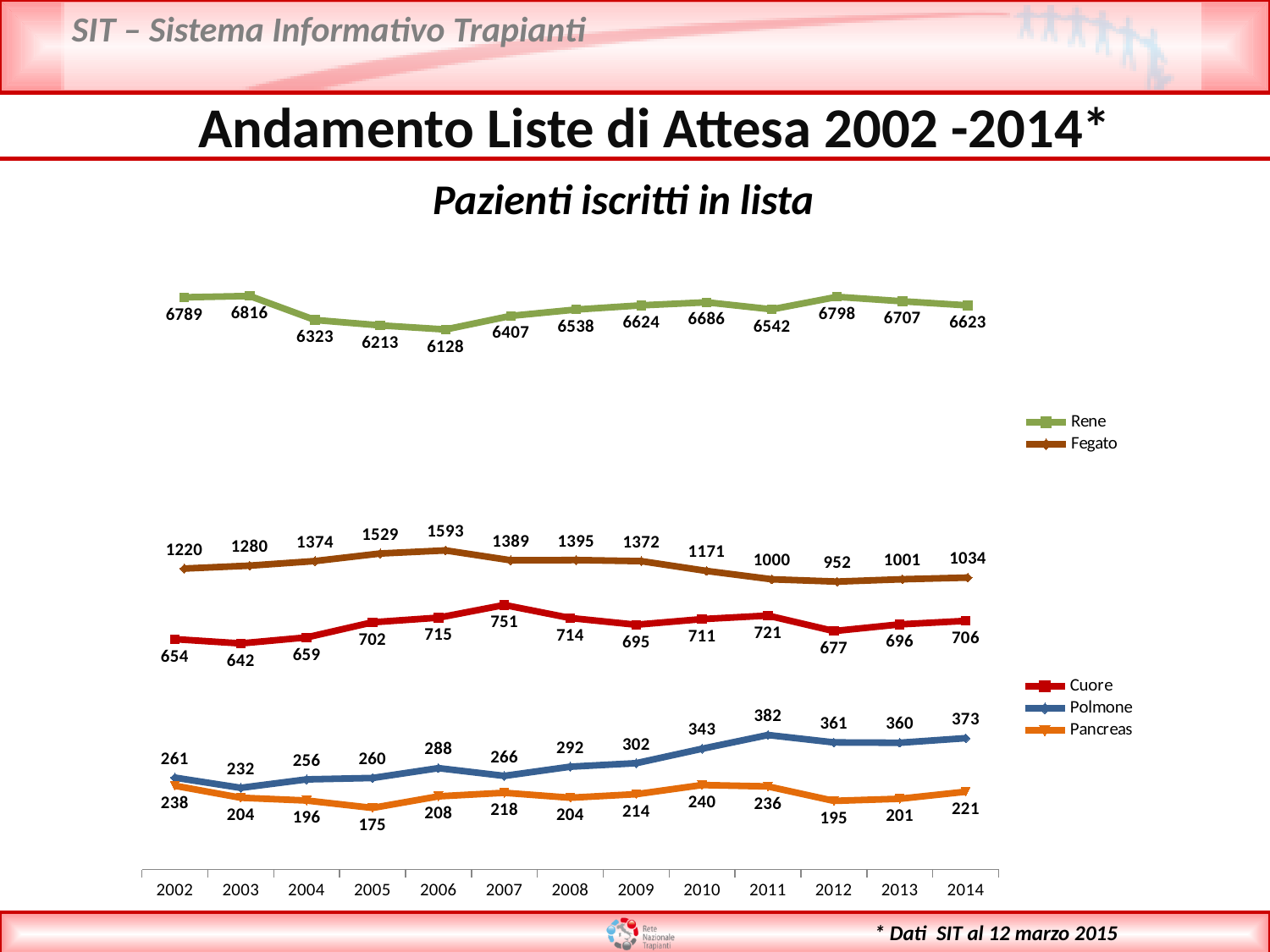
What is the difference between the Rene values for 2003 and 2002? 27 How many series does the legend list? 5 What is the difference between the Fegato values for 2006 and 2002? 373 What is the value for Rene in 2006? 6128 In which year is the Pancreas series at its lowest? 2005 Which is larger for Cuore: the value in 2007 or the value in 2011? 2007 What kind of chart is shown on the slide? line chart What is the value for Fegato in 2014? 1034 In which year is the Fegato series at its highest? 2006 What is the value for Pancreas in 2010? 240 Overall, does the Polmone series rise or fall from 2002 to 2014? rise How many years are shown on the x axis? 13